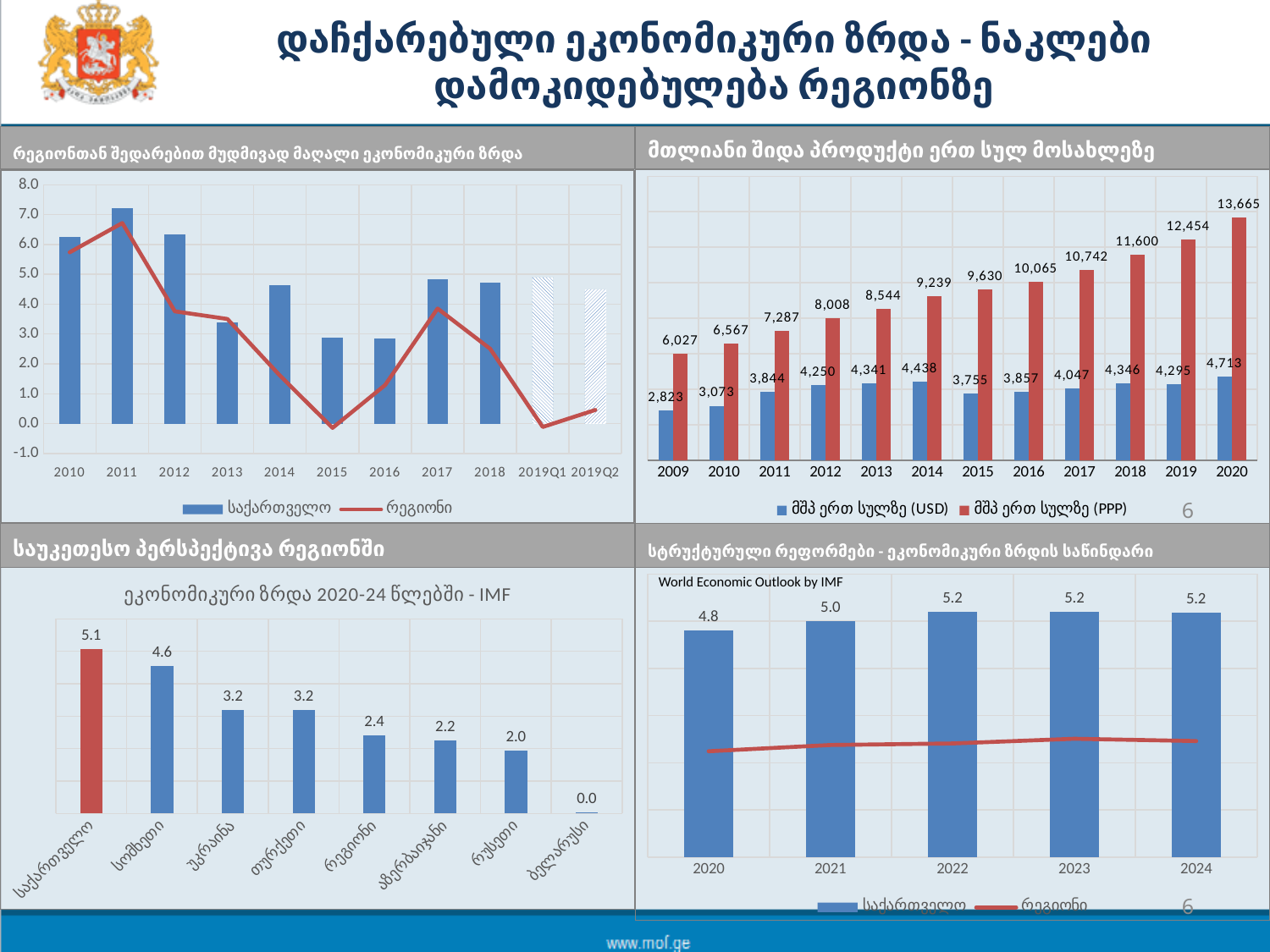
In the top-right chart (მთლიანი შიდა პროდუქტი ერთ სულ მოსახლეზე), what is the difference between the PPP and USD values for 2019? 8,159 In the top-right chart (მთლიანი შიდა პროდუქტი ერთ სულ მოსახლეზე), which year has the lowest USD value? 2009 In the bottom-right chart (World Economic Outlook by IMF), do the bar values rise or fall from 2020 to 2022? rise In the top-right chart (მთლიანი შიდა პროდუქტი ერთ სულ მოსახლეზე), what is the PPP value for 2020? 13,665 In the top-right chart (მთლიანი შიდა პროდუქტი ერთ სულ მოსახლეზე), what is the USD value for 2009? 2,823 In the bottom-left chart (ეკონომიკური ზრდა 2020-24 წლებში - IMF), what is the difference between საქართველო and რეგიონი? 2.7 In the top-left chart, is the bar value for 2011 greater or less than 6.0? greater In the bottom-left chart (ეკონომიკური ზრდა 2020-24 წლებში - IMF), how many categories are shown? 8 In the bottom-right chart (World Economic Outlook by IMF), what is the value for 2020? 4.8 In the bottom-left chart (ეკონომიკური ზრდა 2020-24 წლებში - IMF), what is the value for სომხეთი? 4.6 In the bottom-left chart (ეკონომიკური ზრდა 2020-24 წლებში - IMF), which category has the highest value? საქართველო In the top-right chart (მთლიანი შიდა პროდუქტი ერთ სულ მოსახლეზე), how many series does the legend list? 2